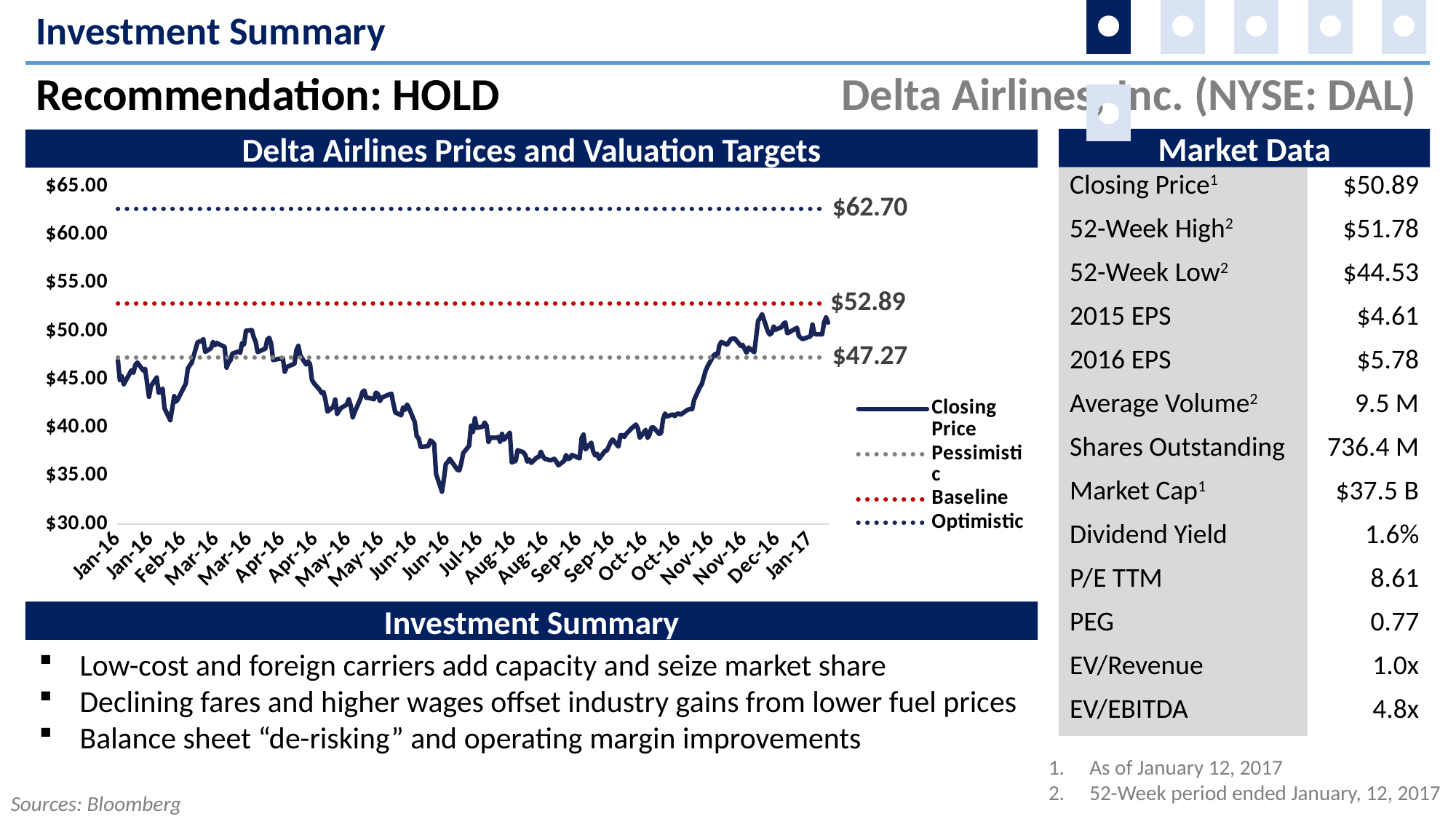
In the "Delta Airlines Prices and Valuation Targets" chart, is the lowest closing price shown (around Jun-16) greater or less than $35.00? less What kind of chart is "Delta Airlines Prices and Valuation Targets"? line chart In the "Delta Airlines Prices and Valuation Targets" chart, what is the value of the Optimistic target line? $62.70 In the "Delta Airlines Prices and Valuation Targets" chart, what is the value of the Baseline target line? $52.89 In the "Delta Airlines Prices and Valuation Targets" chart, which valuation target line is the highest? Optimistic In the "Delta Airlines Prices and Valuation Targets" chart, does the closing price rise or fall between Jun-16 and Dec-16? rise In the "Delta Airlines Prices and Valuation Targets" chart, what is the difference between the Baseline and Pessimistic target values? $5.62 In the "Delta Airlines Prices and Valuation Targets" chart, what is the value of the Pessimistic target line? $47.27 How many series does the legend of the "Delta Airlines Prices and Valuation Targets" chart list? 4 In the "Delta Airlines Prices and Valuation Targets" chart, what is the difference between the Optimistic and Baseline target values? $9.81 In the "Delta Airlines Prices and Valuation Targets" chart, what colour is the Baseline line? red In the "Delta Airlines Prices and Valuation Targets" chart, which valuation target line is the lowest? Pessimistic